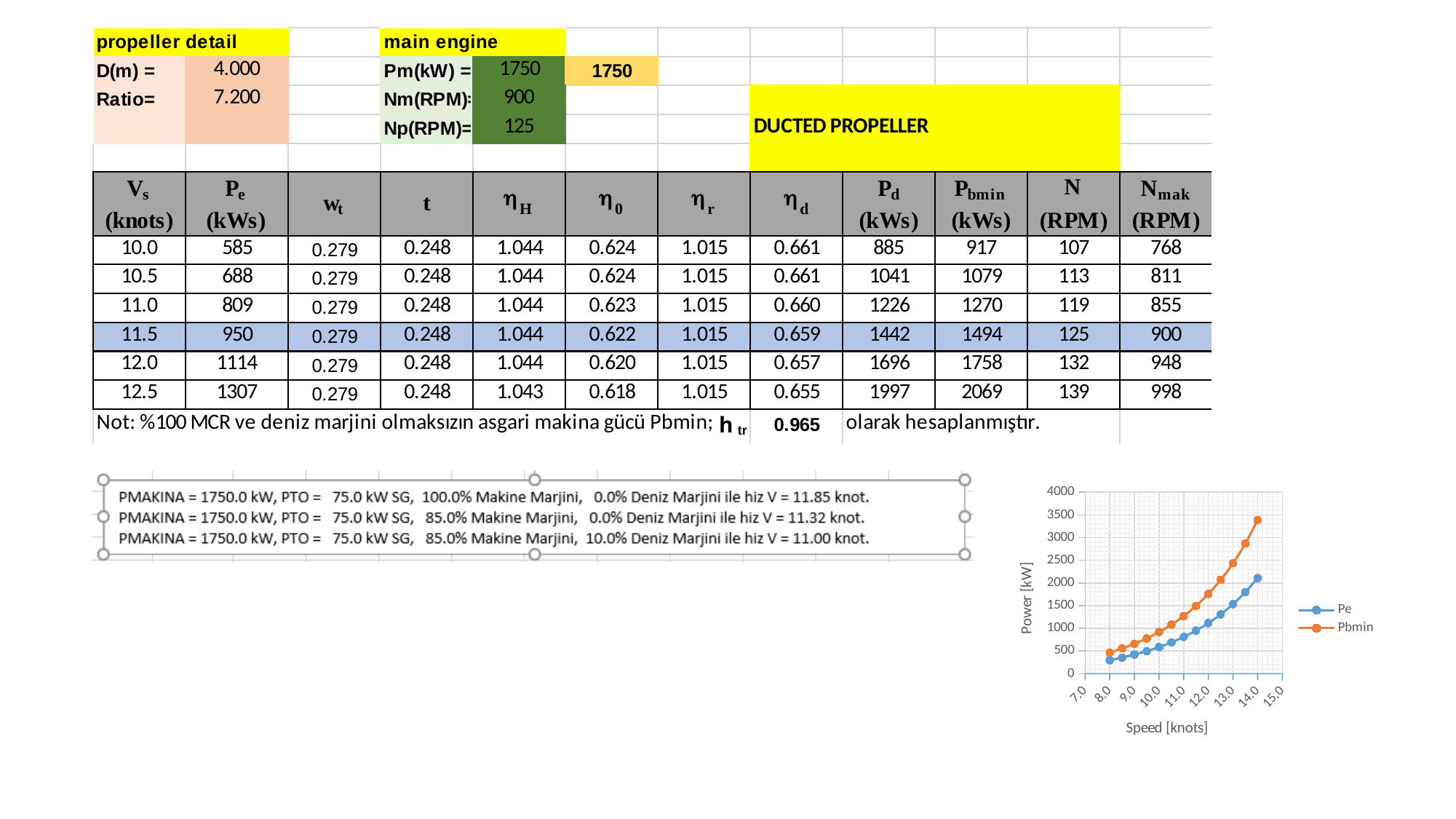
What is the title of the x axis of the chart? Speed [knots] Which series has the lowest value at 8.0 knots, Pe or Pbmin? Pe What kind of chart is shown at the bottom right of the slide? line chart How many series does the legend of the Power vs Speed chart list? 2 Is the Pe value at 14.0 knots greater or less than 1500? greater Which series is higher at 14.0 knots, Pe or Pbmin? Pbmin Is the Pe value at 8.0 knots greater or less than 500? less Is the Pe value at 12.0 knots greater or less than 1500? less What are the two series named in the legend of the chart? Pe and Pbmin Do the Pbmin values rise or fall as speed increases along the x axis? rise